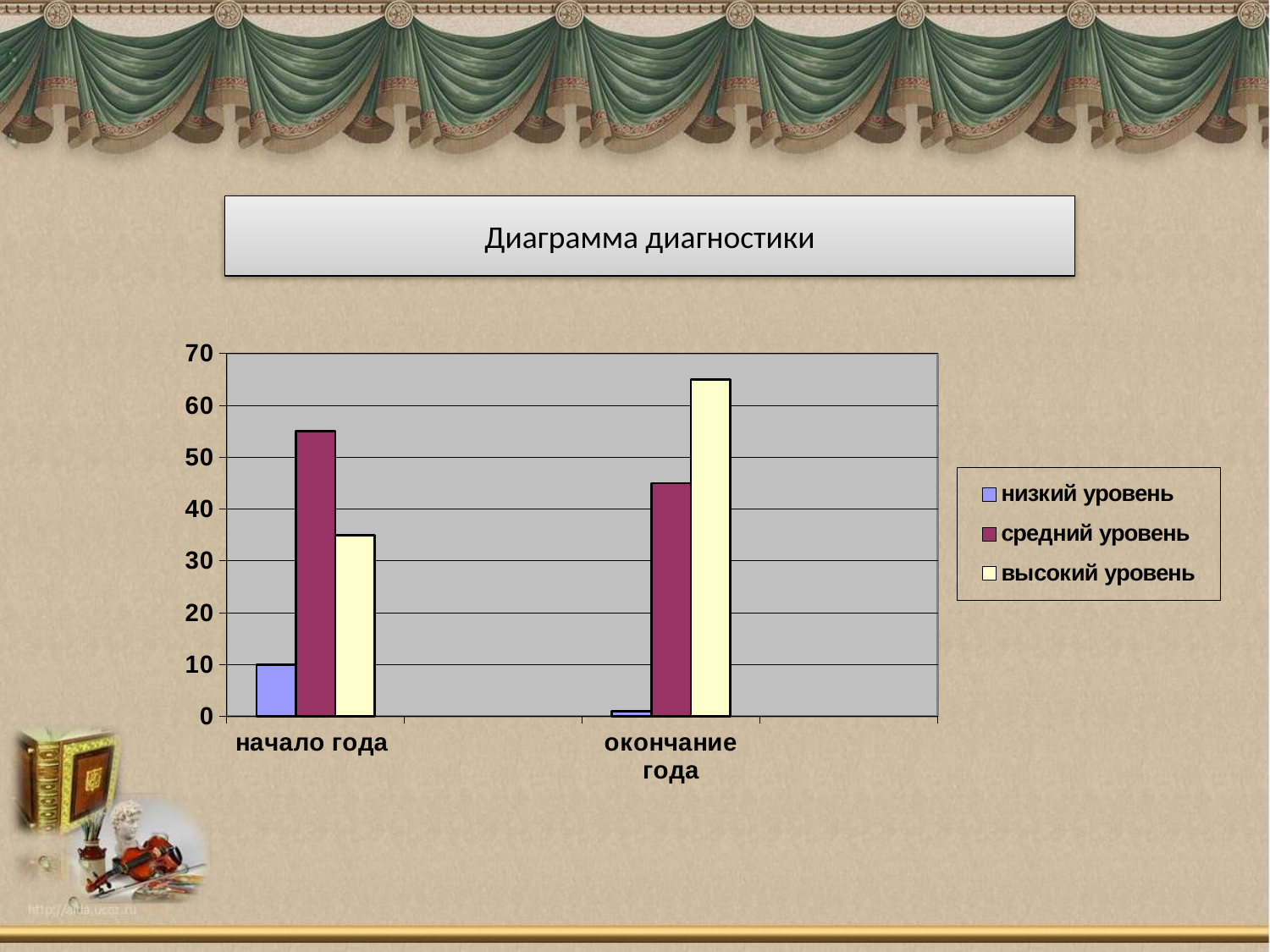
Which series has the highest value at начало года? средний уровень What is the title shown above the chart? Диаграмма диагностики What is the value for низкий уровень at начало года? 10 How many series does the legend list? 3 Is the value for высокий уровень at начало года greater or less than 40? less How many categories are shown on the x axis? 2 What kind of chart is shown on the slide? bar chart Which series has the lowest value at окончание года? низкий уровень Is the value for высокий уровень at окончание года greater or less than 60? greater Is the value for средний уровень at окончание года greater or less than 40? greater For высокий уровень, which category has the larger value: начало года or окончание года? окончание года